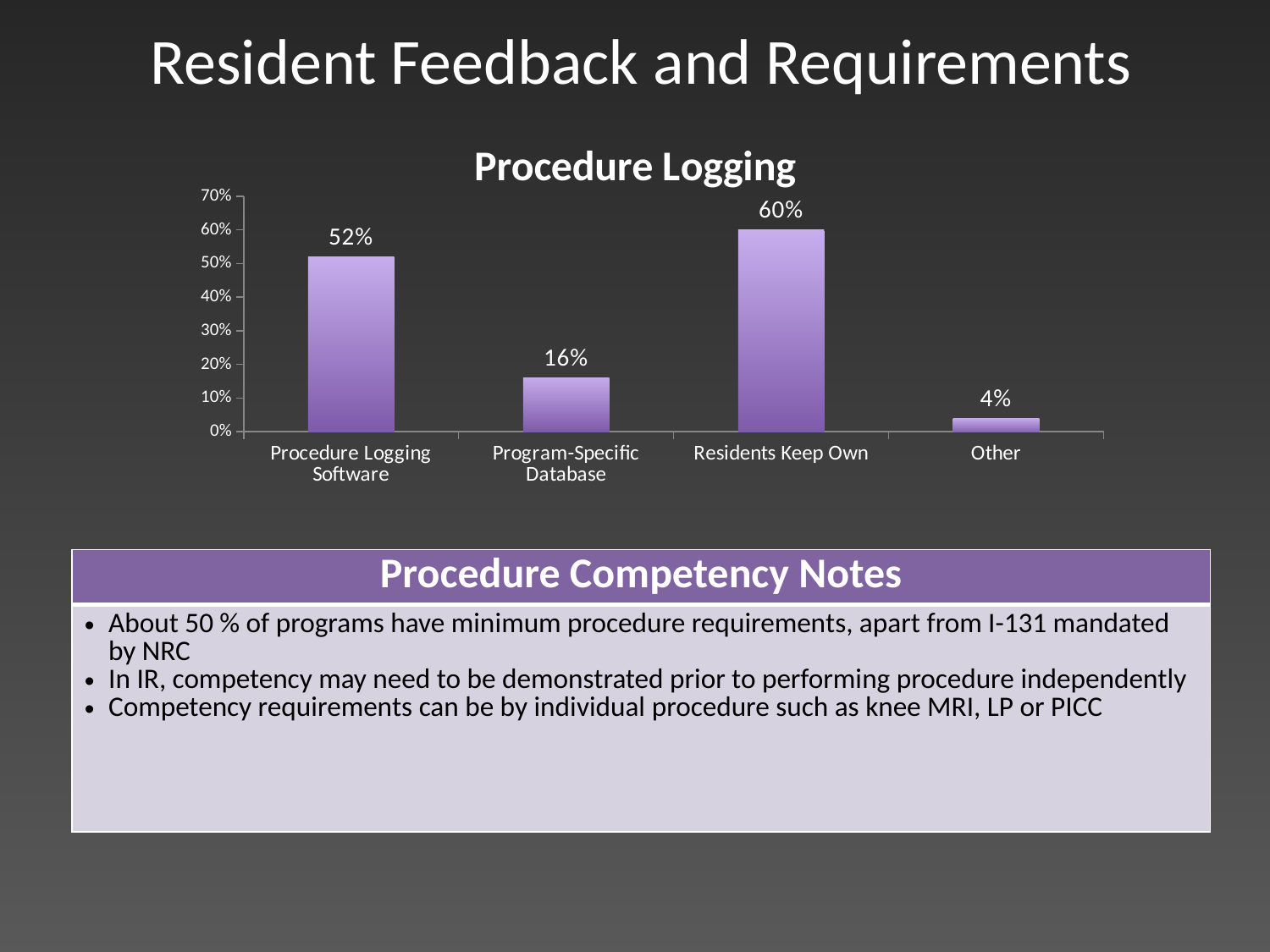
Which category has the lowest value? Other What is the value for Other? 4% What is the value for Residents Keep Own? 60% Is the value for Residents Keep Own greater or less than 50%? greater What is the difference between the values for Residents Keep Own and Procedure Logging Software? 8% What is the value for Procedure Logging Software? 52% Which is larger, the value for Procedure Logging Software or the value for Program-Specific Database? Procedure Logging Software Which category has the highest value? Residents Keep Own What is the value for Program-Specific Database? 16% What is the difference between the values for Program-Specific Database and Other? 12% What is the title of the chart? Procedure Logging How many categories are shown in the chart? 4